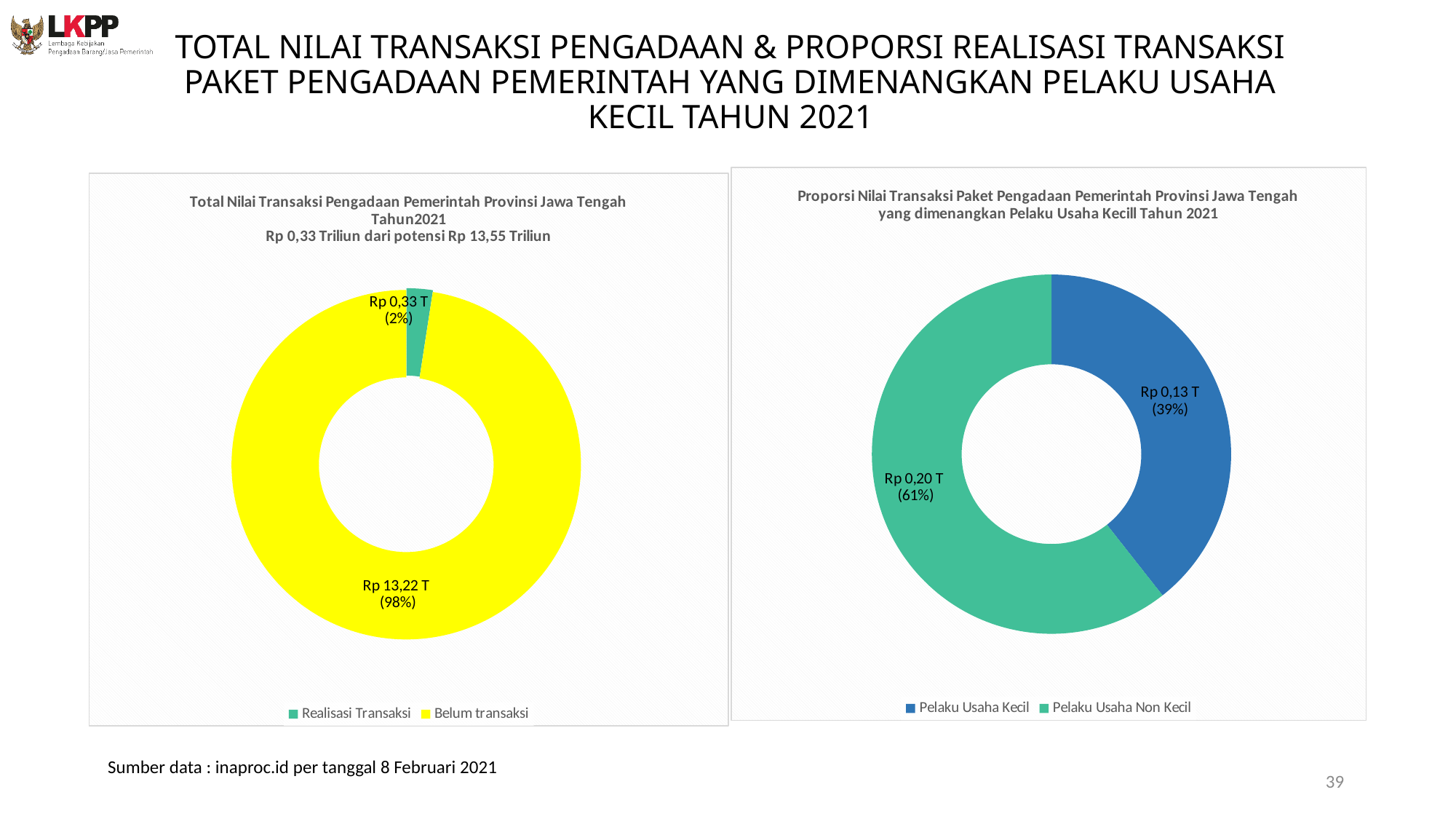
How many entries does the legend of the left chart list? 2 In the right chart (Proporsi Nilai Transaksi Paket Pengadaan ... Pelaku Usaha Kecil Tahun 2021), what value is shown for Pelaku Usaha Kecil? Rp 0,13 T In the left chart (Total Nilai Transaksi Pengadaan Pemerintah Provinsi Jawa Tengah Tahun 2021), what value is shown for Realisasi Transaksi? Rp 0,33 T In the left chart, what percentage share does Realisasi Transaksi have? 2% In the left chart, what percentage share does Belum transaksi have? 98% In the right chart, which category is the smallest? Pelaku Usaha Kecil In the left chart, what value is shown for Belum transaksi? Rp 13,22 T In the right chart, what value is shown for Pelaku Usaha Non Kecil? Rp 0,20 T What type of chart is the right chart? Doughnut (pie) chart In the left chart, which category is the largest? Belum transaksi In the right chart, what percentage share does Pelaku Usaha Kecil have? 39% In the right chart, which is larger: Pelaku Usaha Kecil or Pelaku Usaha Non Kecil? Pelaku Usaha Non Kecil